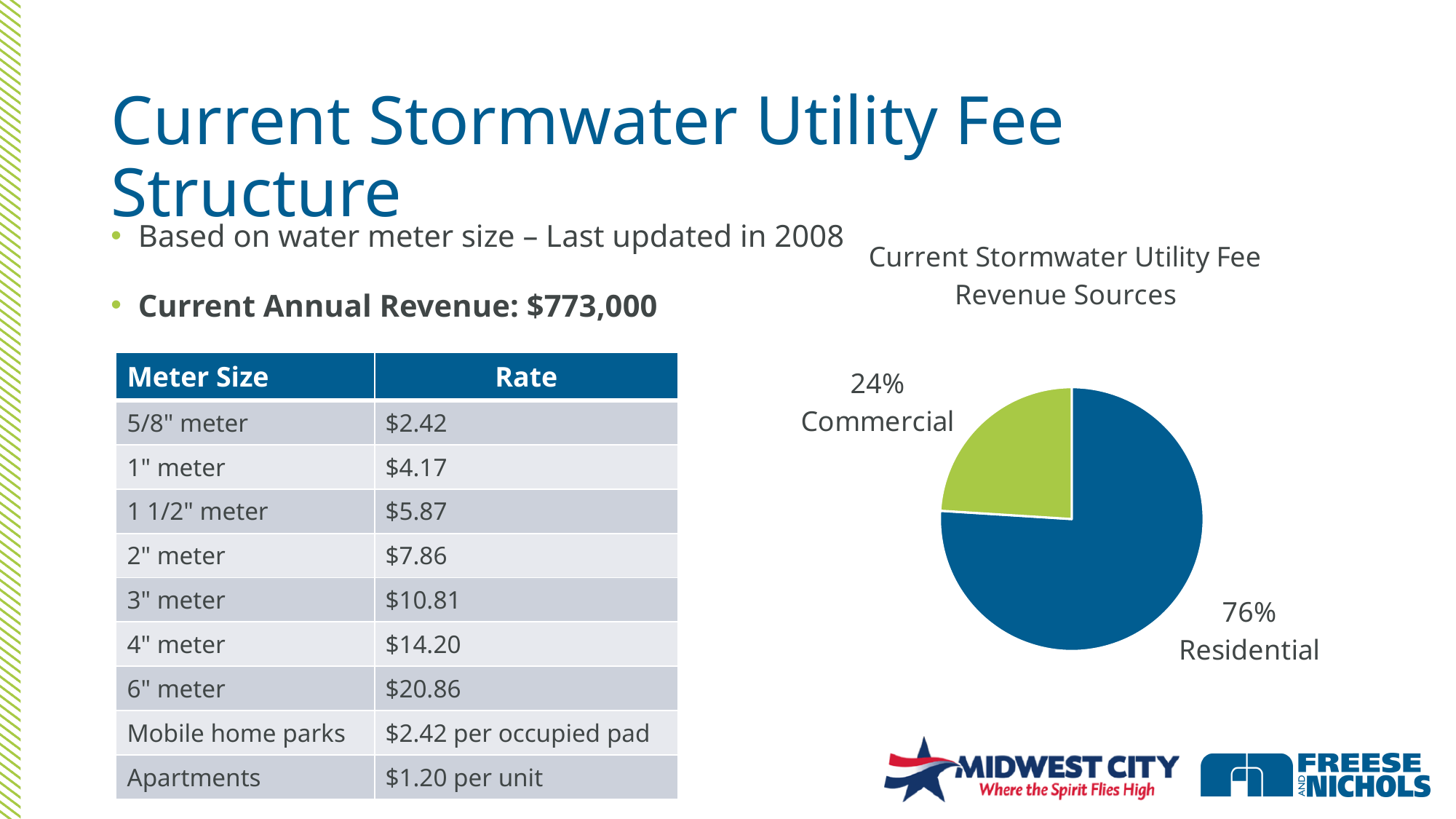
What share of revenue comes from Residential sources in the pie chart? 76% Which is larger in the pie chart, the Commercial share or the Residential share? Residential What colour is the Commercial slice in the pie chart? Green How many slices does the pie chart have? 2 What is the title of the pie chart? Current Stormwater Utility Fee Revenue Sources What kind of chart is shown on the slide? Pie chart Which revenue source has the largest slice in the pie chart? Residential What share of revenue comes from Commercial sources in the pie chart? 24% Which revenue source has the smallest slice in the pie chart? Commercial What is the difference in percentage points between the Residential and Commercial shares in the pie chart? 52 percentage points